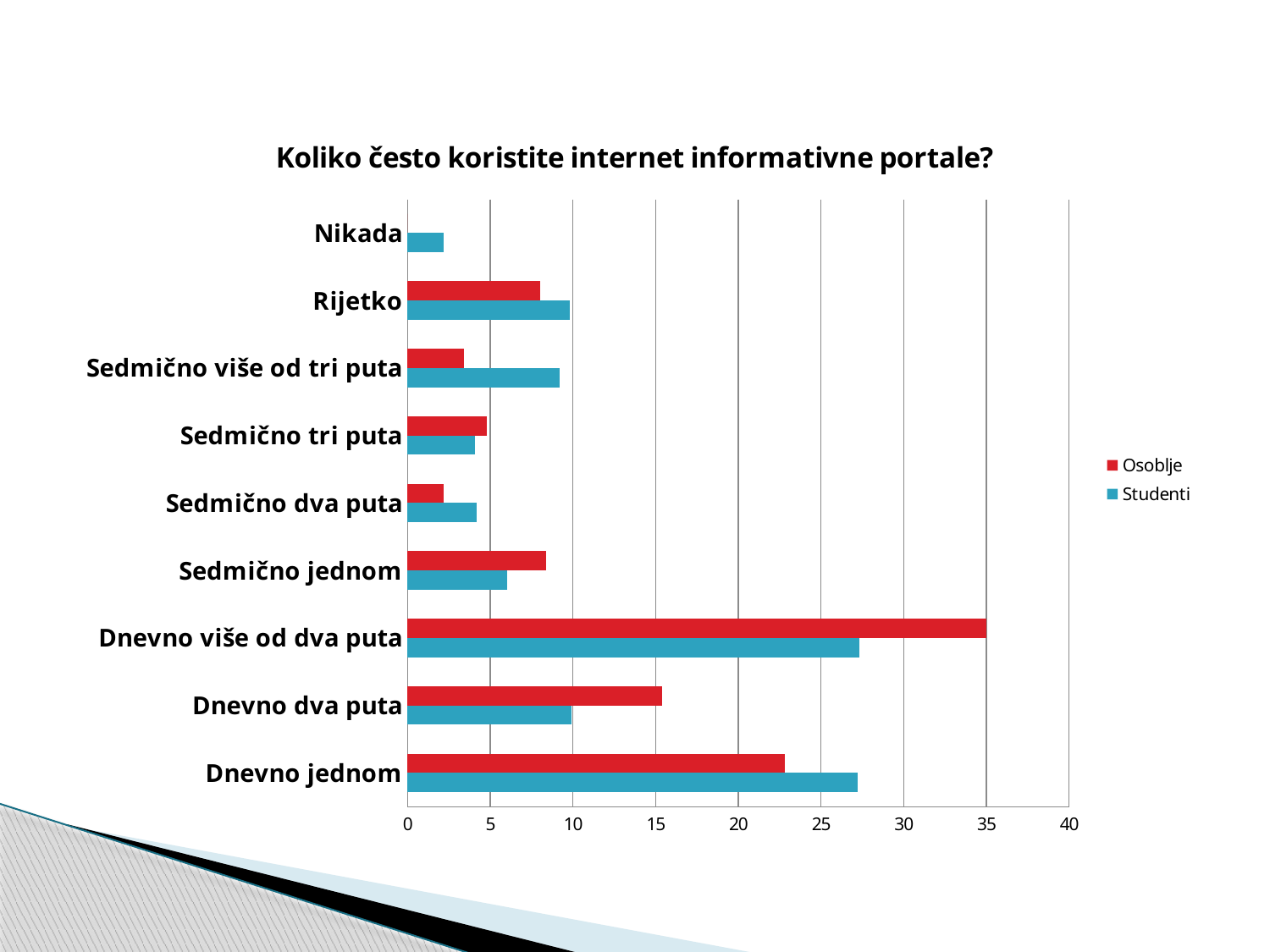
Is the value for Studenti in the category Dnevno dva puta greater or less than 15? less In the category Dnevno dva puta, which series has the larger value, Osoblje or Studenti? Osoblje In the category Sedmično više od tri puta, which series has the larger value, Osoblje or Studenti? Studenti Is the value for Osoblje in the category Dnevno jednom greater or less than 20? greater Is the value for Studenti in the category Dnevno više od dva puta greater or less than 25? greater Which category has the highest value for Osoblje? Dnevno više od dva puta How many series does the legend list? 2 What kind of chart is shown on the slide? bar chart What is the title of the chart? Koliko često koristite internet informativne portale? How many categories are shown on the chart? 9 Which category has the lowest value for Osoblje? Nikada Which category has the lowest value for Studenti? Nikada